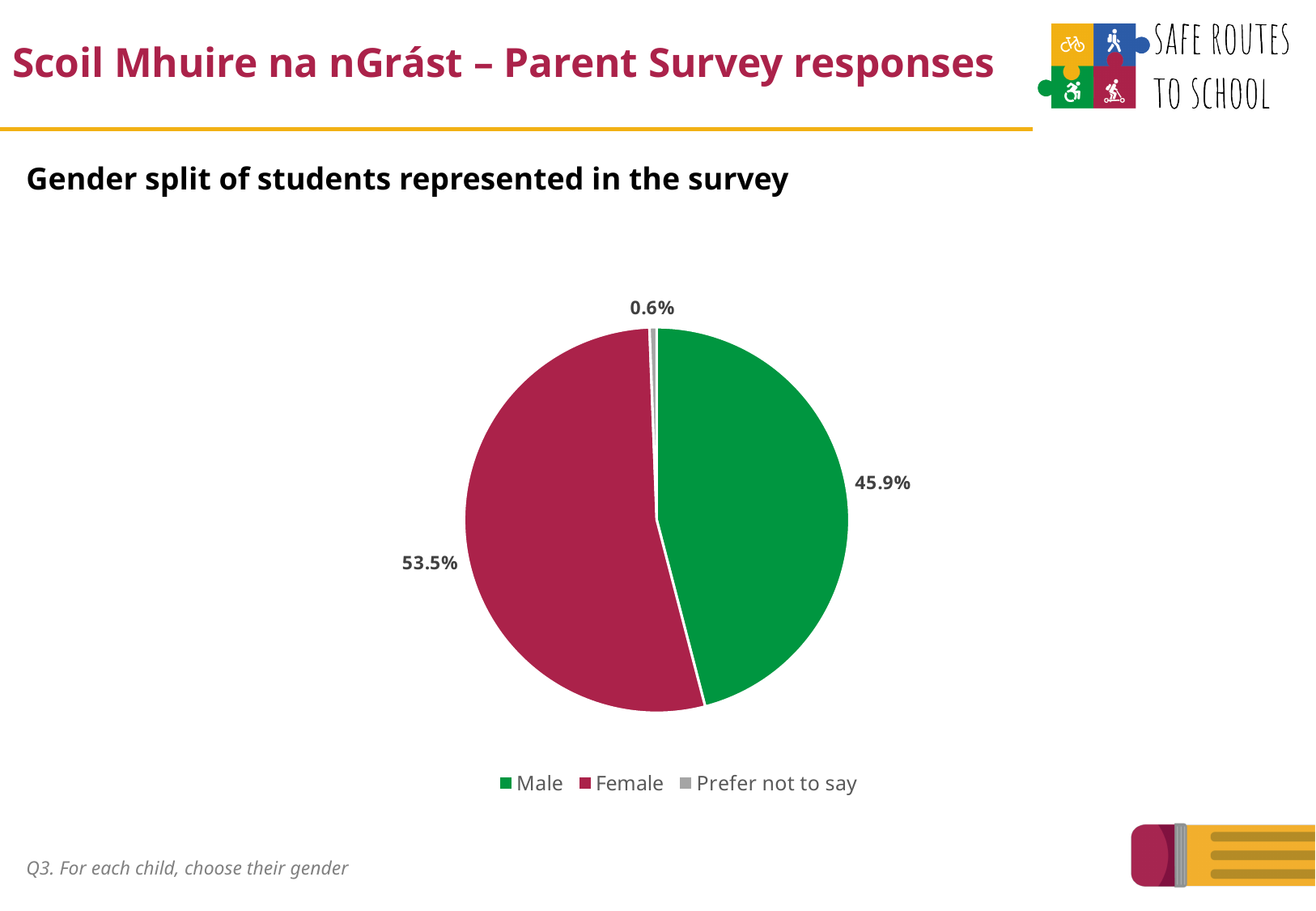
What is the difference in percentage points between the Female and Male shares? 7.6 What colour represents Male in the pie chart? green How many categories does the legend list? 3 Which is larger, the Male share or the Female share? Female What is the title of the chart? Gender split of students represented in the survey Which category has the smallest share of the pie? Prefer not to say What percentage of responses chose 'Prefer not to say'? 0.6% Which category has the largest share of the pie? Female What percentage of students represented in the survey are Female? 53.5% What type of chart is shown on the slide? pie chart What percentage of students represented in the survey are Male? 45.9%